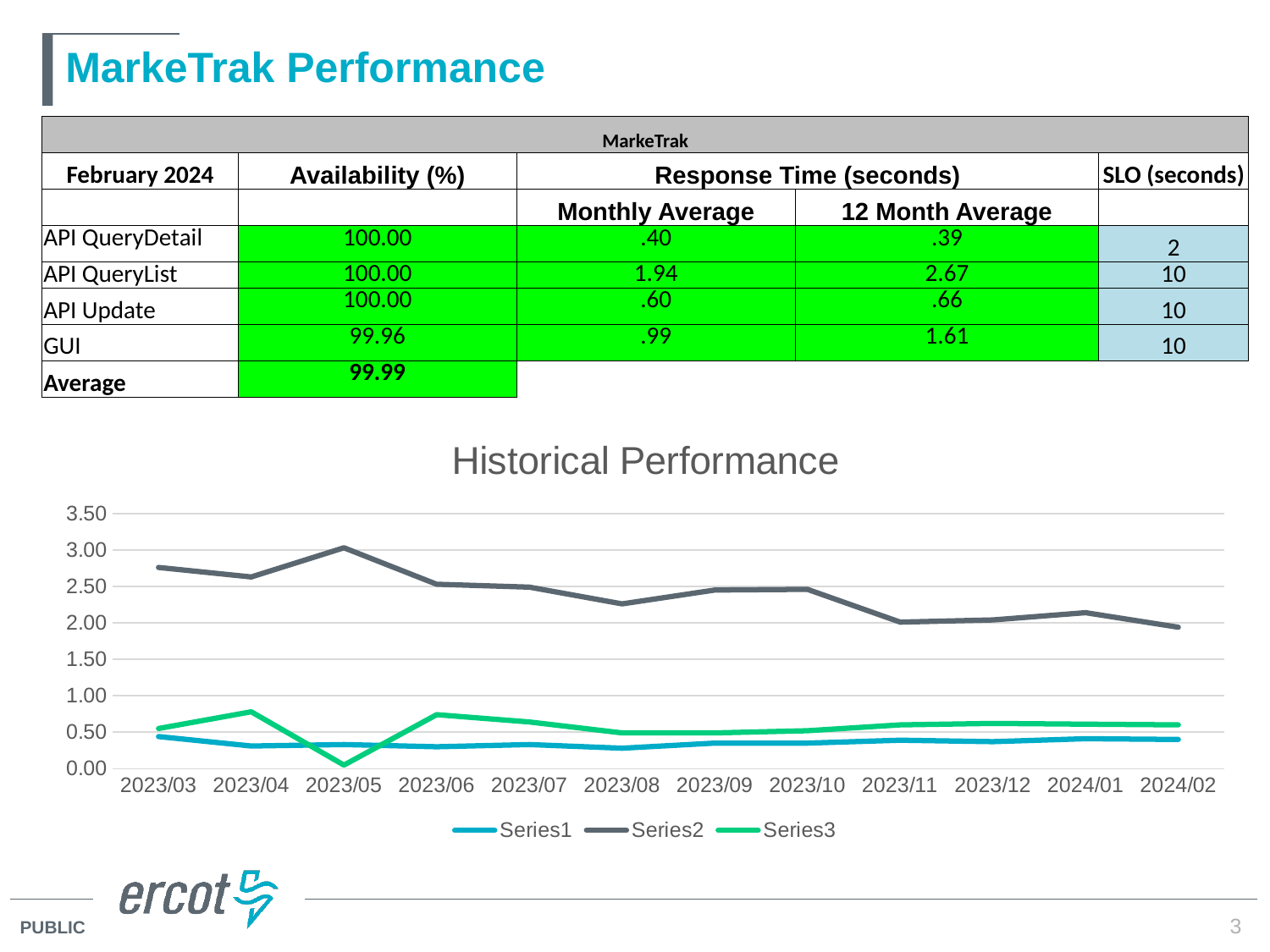
In the Historical Performance chart, is the value of Series2 at 2023/03 greater or less than 2.50? greater In the Historical Performance chart, at which month does Series2 reach its highest value? 2023/05 In the Historical Performance chart, is the value of Series2 at 2023/08 greater or less than 2.50? less In the Historical Performance chart, is the value of Series3 at 2023/04 greater or less than 0.50? greater In the Historical Performance chart, does Series2 generally rise or fall from 2023/03 to 2024/02? fall In the Historical Performance chart, which series has the larger value at 2023/05: Series1 or Series3? Series1 How many series does the legend of the Historical Performance chart list? 3 What kind of chart is shown under the title "Historical Performance"? line chart How many months are plotted along the x axis of the Historical Performance chart? 12 What is the title of the line chart on the slide? Historical Performance In the Historical Performance chart, at which month does Series3 reach its lowest value? 2023/05